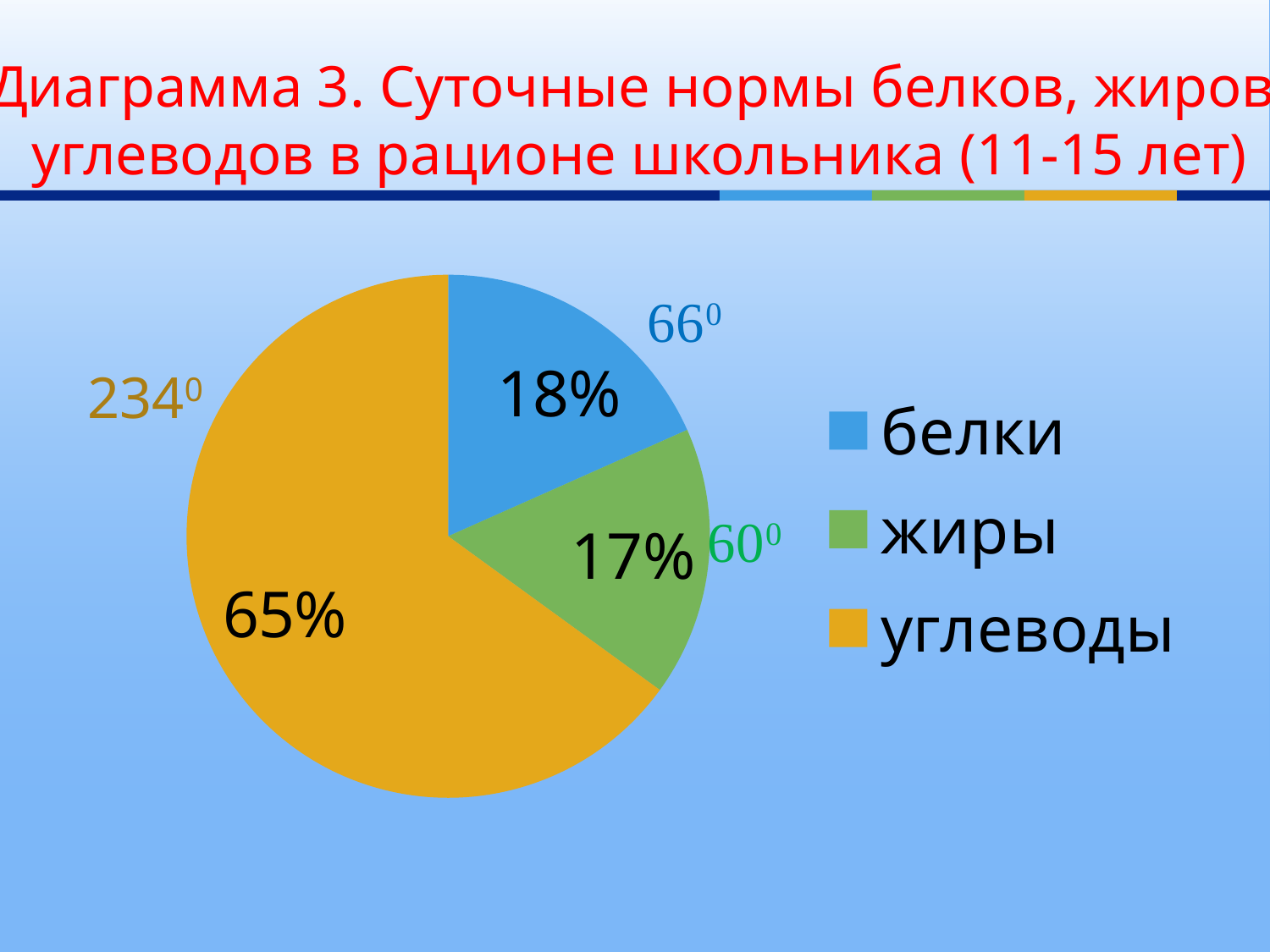
Which category has the smallest share of the pie? жиры What percentage of the pie is углеводы? 65% What angle in degrees is labelled for the белки slice? 66⁰ What type of chart is shown on the slide? pie chart Which is larger, the share for белки or the share for жиры? белки What percentage of the pie is жиры? 17% What percentage of the pie is белки? 18% What is the difference in percentage points between углеводы and белки? 47% What colour is the углеводы slice in the pie chart? yellow/orange Which category has the largest share of the pie? углеводы How many slices does the pie chart have? 3 What angle in degrees is labelled for the углеводы slice? 234⁰